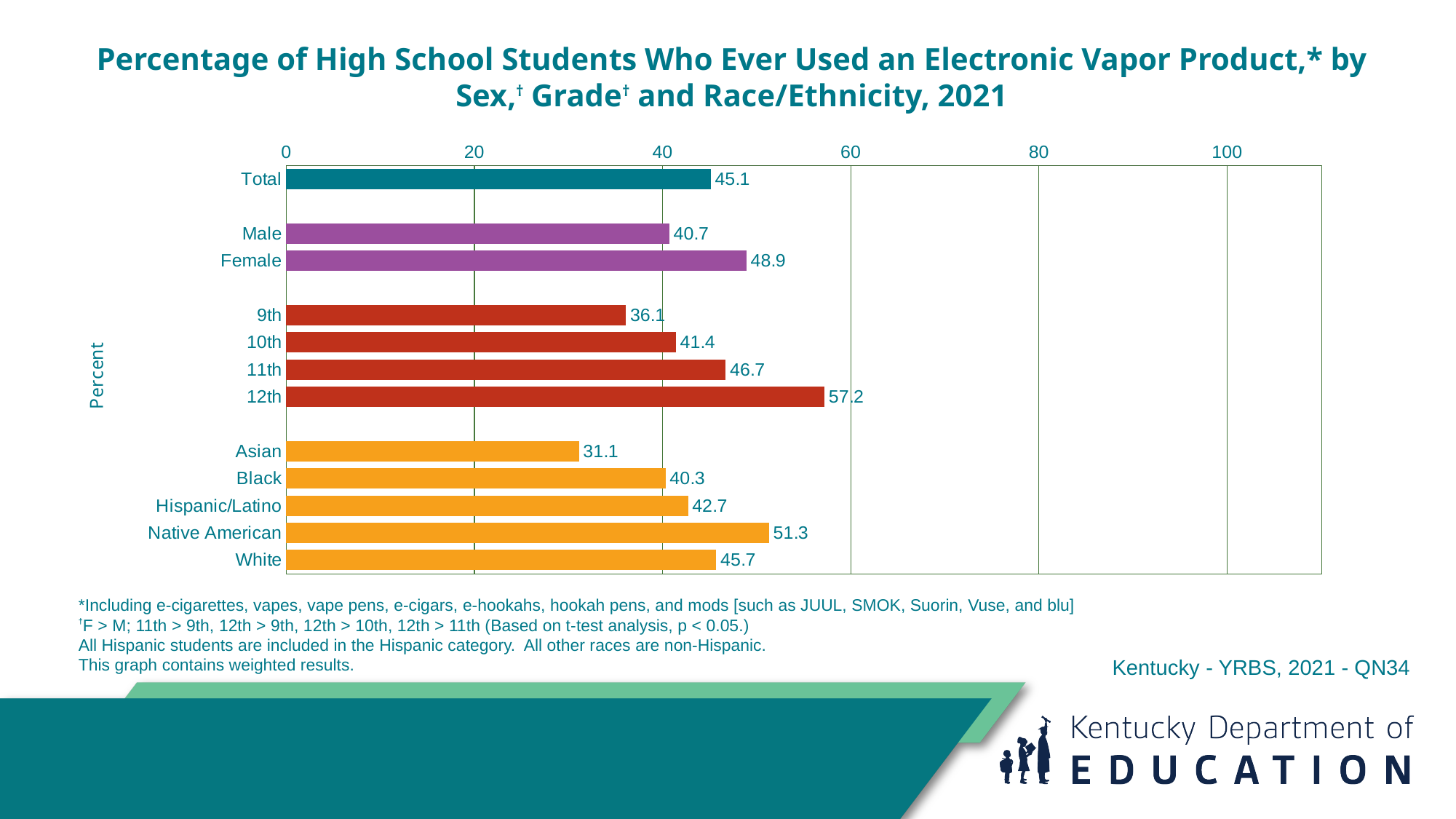
Which is larger, the value for 9th grade or the value for 11th grade? 11th What is the difference between the Female and Male values? 8.2 What is the value for Native American students? 51.3 What is the difference between the White and Black values? 5.4 What is the value for 12th grade? 57.2 Is the value for Hispanic/Latino greater or less than 40? greater Do the values rise or fall from 9th grade to 12th grade? Rise What is the value for Total? 45.1 Which category has the lowest value? Asian Which category has the highest value? 12th How many categories are plotted in the chart? 13 What kind of chart is shown? Bar chart